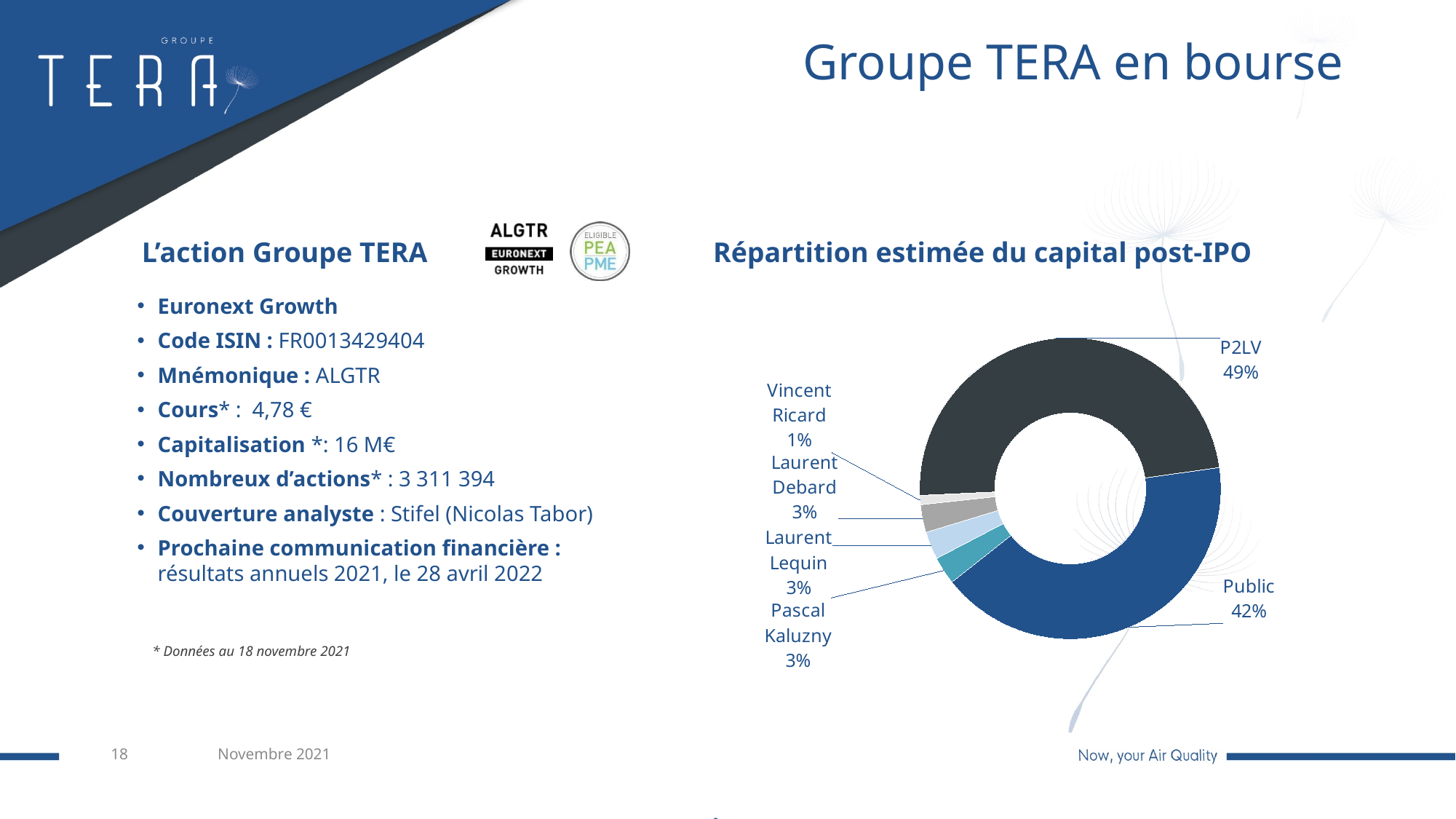
What is the title of the chart on the right of the slide? Répartition estimée du capital post-IPO What share of the capital does the Public hold in the 'Répartition estimée du capital post-IPO' chart? 42% Which holder has the largest share in the 'Répartition estimée du capital post-IPO' chart? P2LV In the 'Répartition estimée du capital post-IPO' chart, what is the difference between the P2LV share and the Public share? 7% What share of the capital does Laurent Debard hold in the 'Répartition estimée du capital post-IPO' chart? 3% What share of the capital does P2LV hold in the 'Répartition estimée du capital post-IPO' chart? 49% What share of the capital does Pascal Kaluzny hold in the 'Répartition estimée du capital post-IPO' chart? 3% Which holder has the smallest share in the 'Répartition estimée du capital post-IPO' chart? Vincent Ricard In the 'Répartition estimée du capital post-IPO' chart, which is larger: the share of P2LV or the share of the Public? P2LV What share of the capital does Vincent Ricard hold in the 'Répartition estimée du capital post-IPO' chart? 1% How many holders are shown in the 'Répartition estimée du capital post-IPO' chart? 6 What kind of chart is the 'Répartition estimée du capital post-IPO' chart? Doughnut (pie) chart